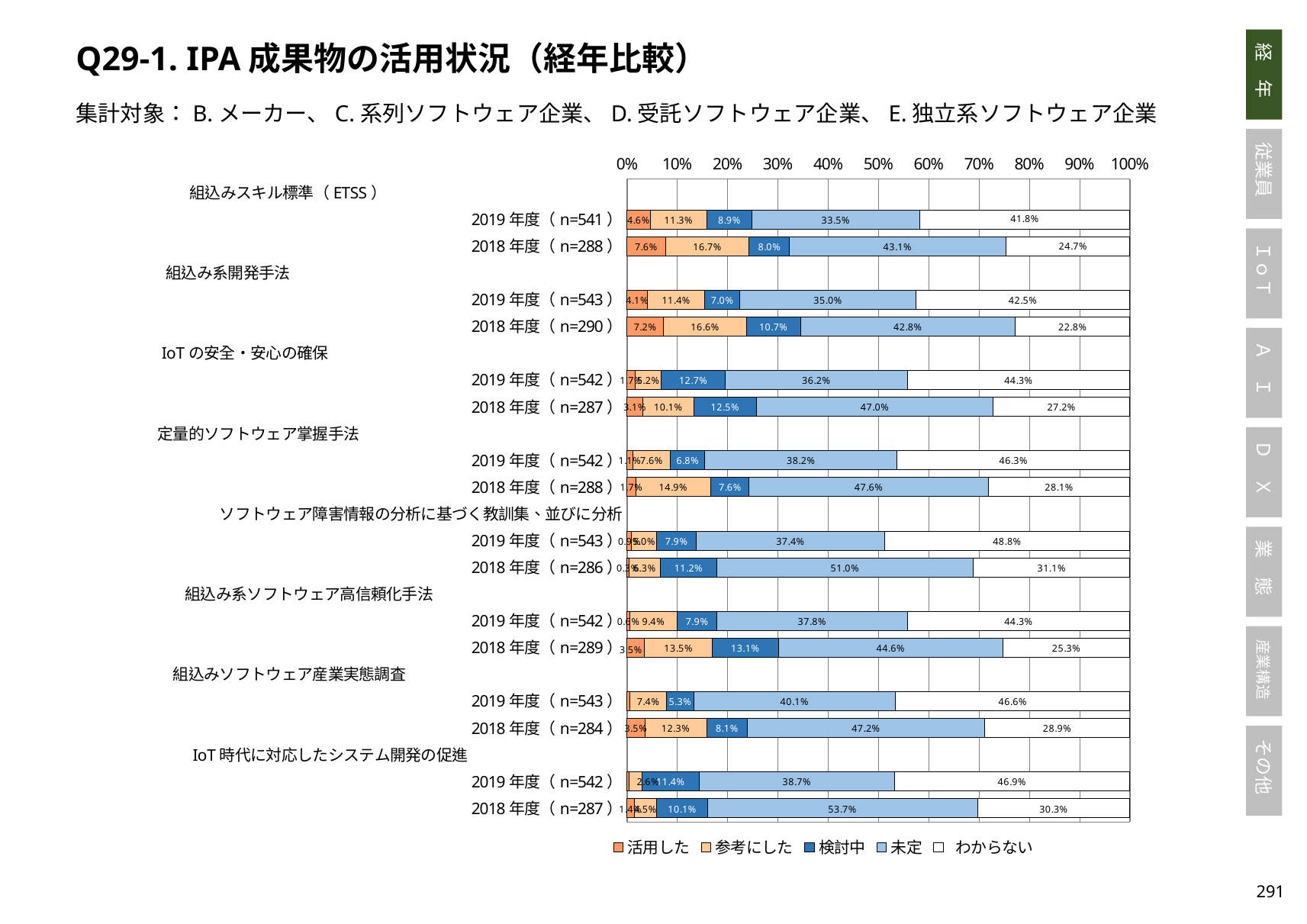
What is the 活用した value for 組込みスキル標準（ETSS） in 2018年度 (n=288)? 7.6% What is the difference between the 未定 values for 組込み系ソフトウェア高信頼化手法 in 2018年度 (n=289) and 2019年度 (n=542)? 6.8% Which is larger: the わからない value for ソフトウェア障害情報の分析に基づく教訓集、並びに分析 in 2019年度 (n=543) or in 2018年度 (n=286)? 2019年度 (n=543) What is the 検討中 value for IoTの安全・安心の確保 in 2019年度 (n=542)? 12.7% What is the 検討中 value for 組込みソフトウェア産業実態調査 in 2018年度 (n=284)? 8.1% What is the 未定 value for 組込みスキル標準（ETSS） in 2019年度 (n=541)? 33.5% Which bar has the highest 未定 value? IoT時代に対応したシステム開発の促進 2018年度 (n=287) How many bars (year rows) are plotted in the chart? 16 What is the 参考にした value for 定量的ソフトウェア掌握手法 in 2018年度 (n=288)? 14.9% What is the わからない value for 組込み系開発手法 in 2018年度 (n=290)? 22.8% How many series does the legend list? 5 What kind of chart is shown on the slide? stacked bar chart